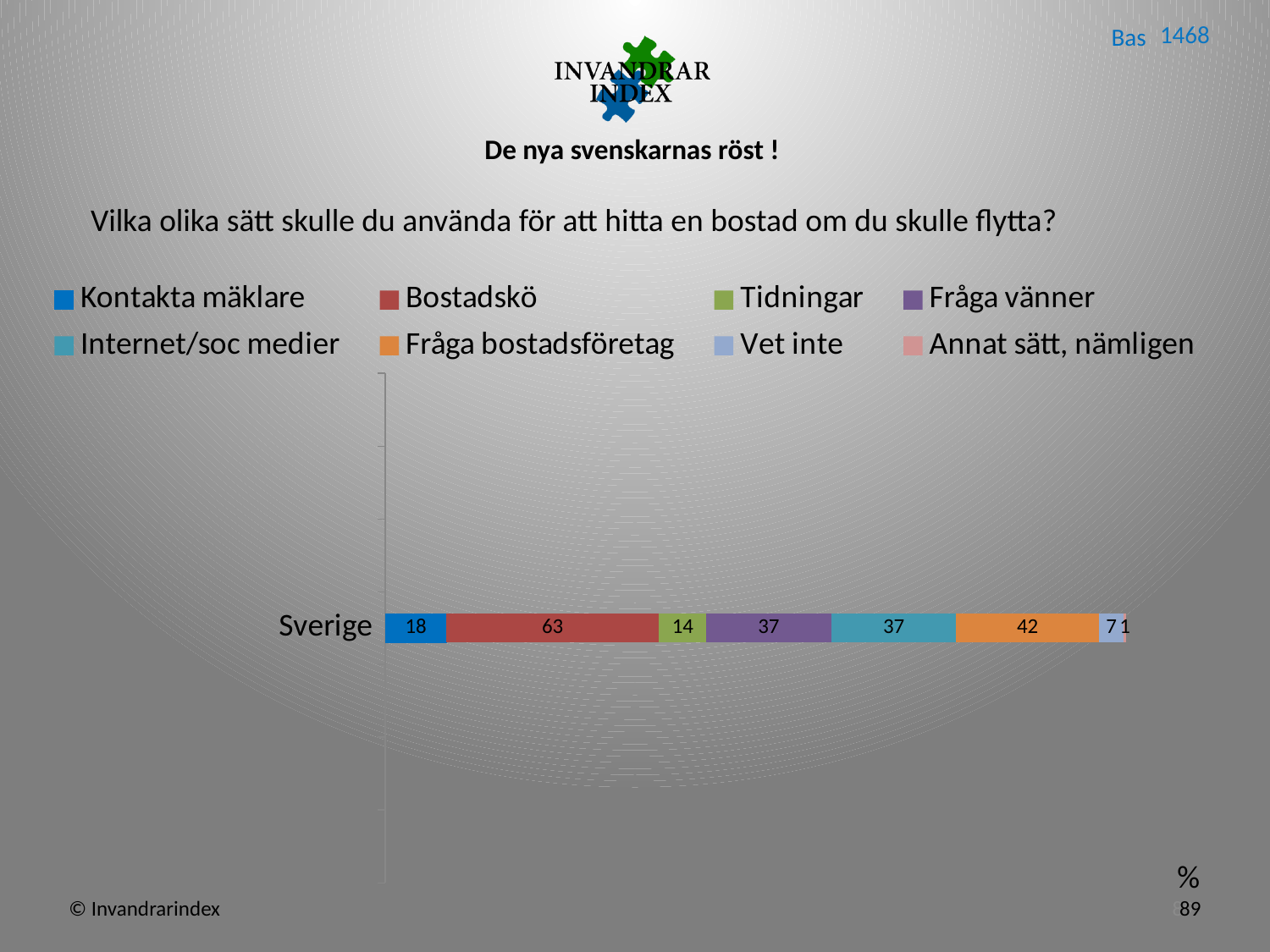
What is the difference between the values for Bostadskö and Fråga bostadsföretag? 21 Which series has the lowest value in the Sverige bar? Annat sätt, nämligen Which series has the highest value in the Sverige bar? Bostadskö What value is shown for Tidningar in the Sverige bar? 14 What value is shown for Bostadskö in the Sverige bar? 63 How many series does the legend list? 8 Which is larger, the value for Kontakta mäklare or the value for Tidningar? Kontakta mäklare What value is shown for Fråga bostadsföretag in the Sverige bar? 42 What is the total of all segments in the Sverige bar? 219 What value is shown for Vet inte in the Sverige bar? 7 What kind of chart is shown on the slide? Stacked bar chart What value is shown for Kontakta mäklare in the Sverige bar? 18